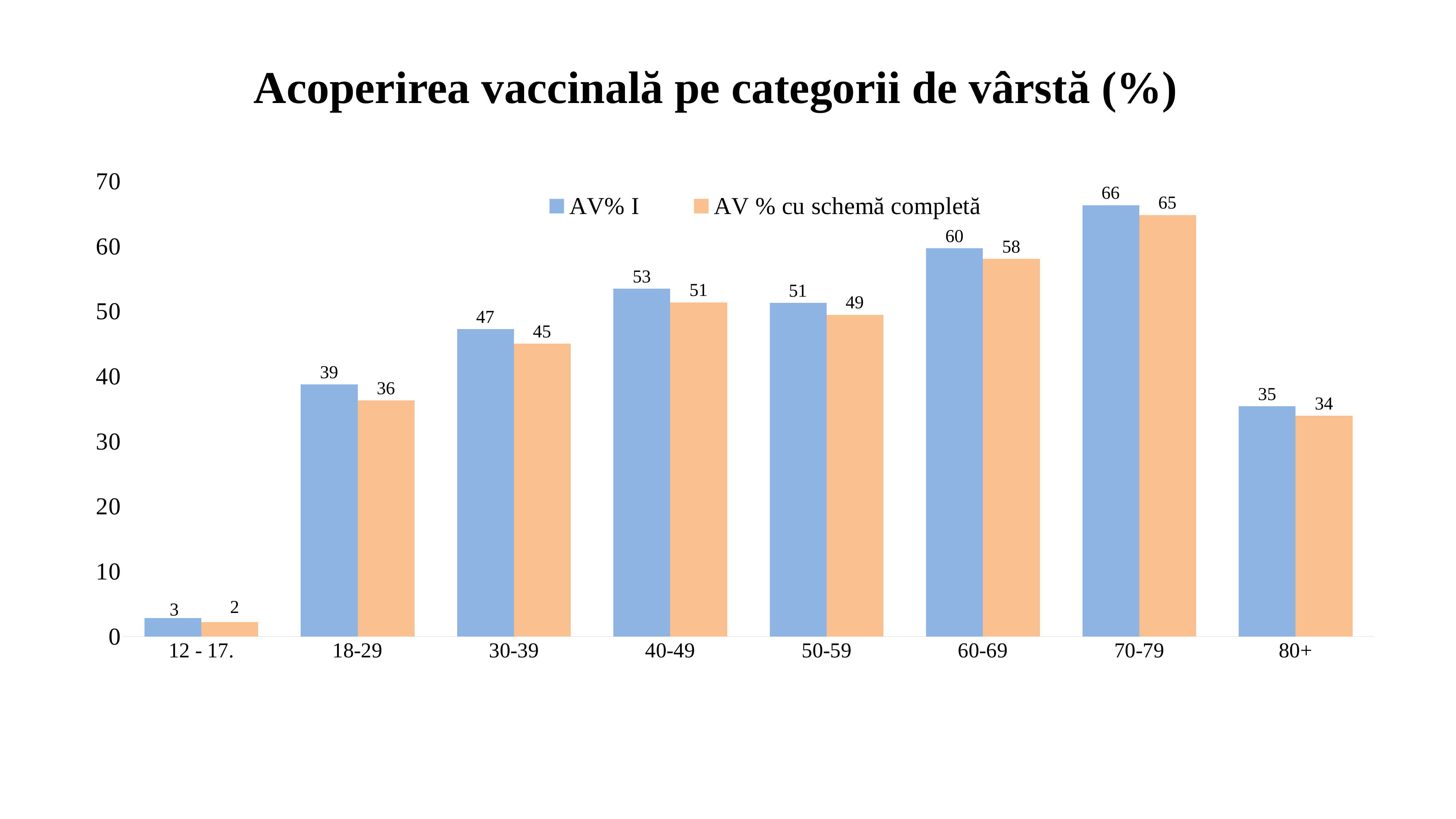
What colour are the bars for the AV % cu schemă completă series? orange What is the difference between the AV% I and AV % cu schemă completă values for the 18-29 age group? 3 Which is larger: the AV% I value for 60-69 or the AV% I value for 80+? 60-69 What is the AV % cu schemă completă value for the 18-29 age group? 36 What is the AV% I value for the 40-49 age group? 53 Which age group has the lowest AV % cu schemă completă value? 12 - 17. How many series does the legend list? 2 What kind of chart is shown on the slide? bar chart Do the AV% I values rise or fall from the 12 - 17. group to the 70-79 group? rise How many age groups are shown on the x axis? 8 What is the title of the chart? Acoperirea vaccinală pe categorii de vârstă (%) Which age group has the highest AV% I value? 70-79